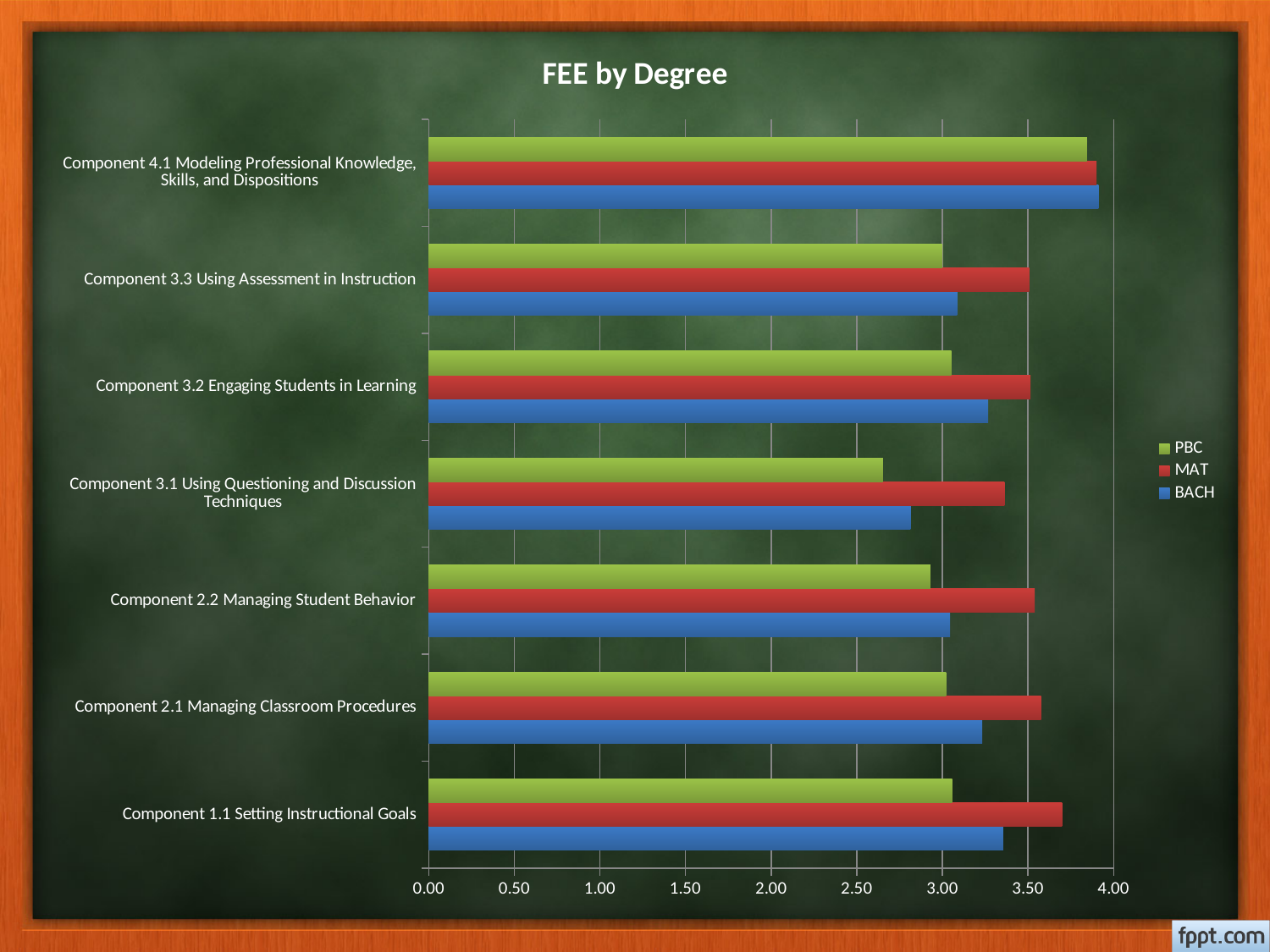
How many series does the legend list? 3 For Component 3.1 Using Questioning and Discussion Techniques, which series has the highest value? MAT For Component 2.2 Managing Student Behavior, which is larger, the MAT value or the PBC value? MAT Is the BACH value for Component 3.1 Using Questioning and Discussion Techniques greater or less than 3.00? less What is the title of the chart? FEE by Degree Which series is shown in red in the legend? MAT Is the MAT value for Component 1.1 Setting Instructional Goals greater or less than 3.50? greater Is the PBC value for Component 3.1 Using Questioning and Discussion Techniques greater or less than 3.00? less For which component is the PBC value lowest? Component 3.1 Using Questioning and Discussion Techniques How many components (categories) are plotted on the chart? 7 What kind of chart is shown on the slide? bar chart